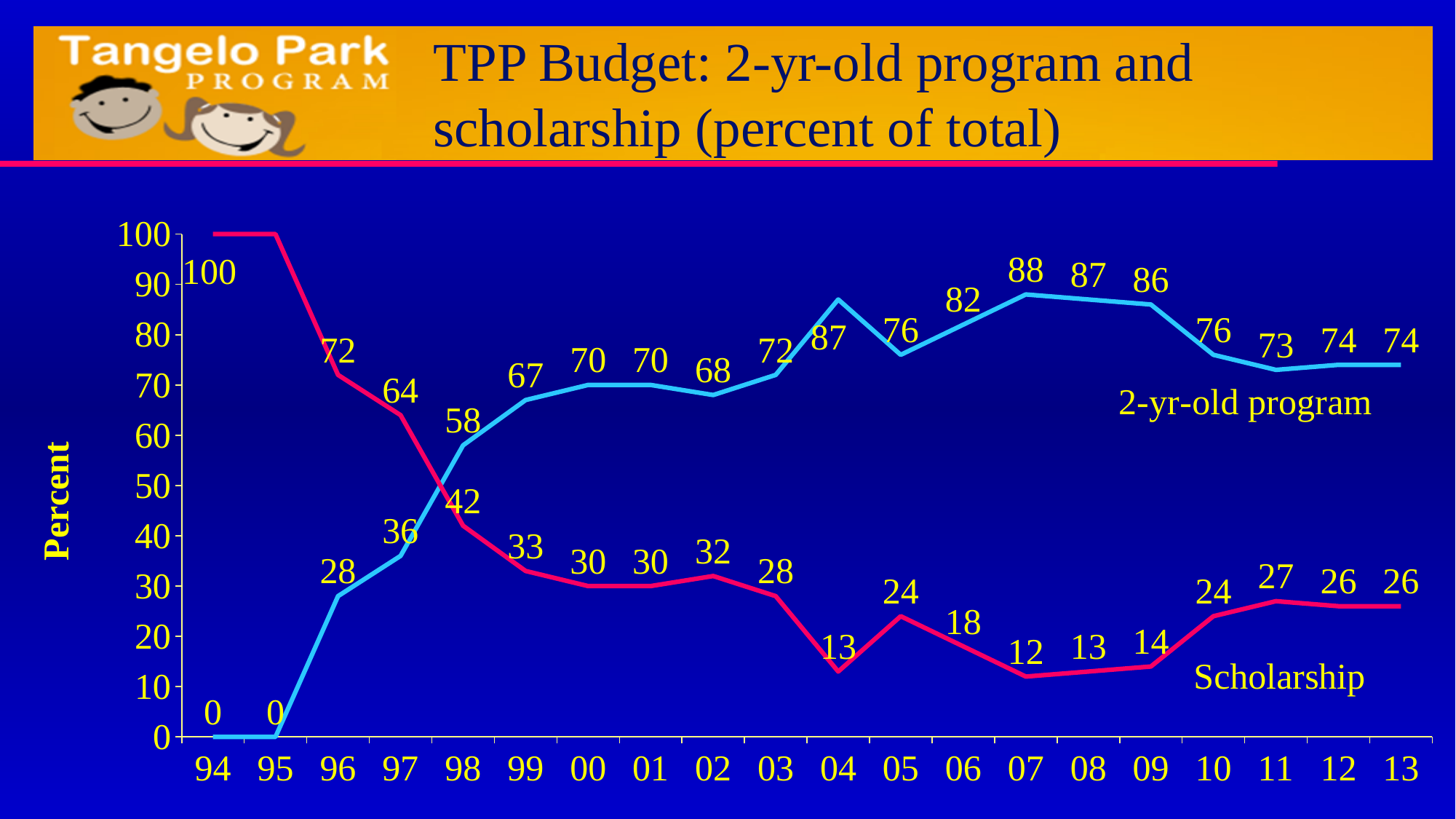
What is the difference between the 2-yr-old program and Scholarship values in 13? 48 How many data series are plotted on the chart? 2 How many years are shown along the x axis? 20 What is the value for Scholarship in 04? 13 In which year does the 2-yr-old program reach its highest value? 07 In which year is the Scholarship value lowest? 07 In 98, which series has the larger value, the 2-yr-old program or Scholarship? 2-yr-old program What is the value for the 2-yr-old program in 96? 28 What kind of chart is shown on the slide? Line chart What is the sum of the 2-yr-old program and Scholarship values in 05? 100 What is the value for the 2-yr-old program in 07? 88 Does the Scholarship line rise or fall from 96 to 99? Fall